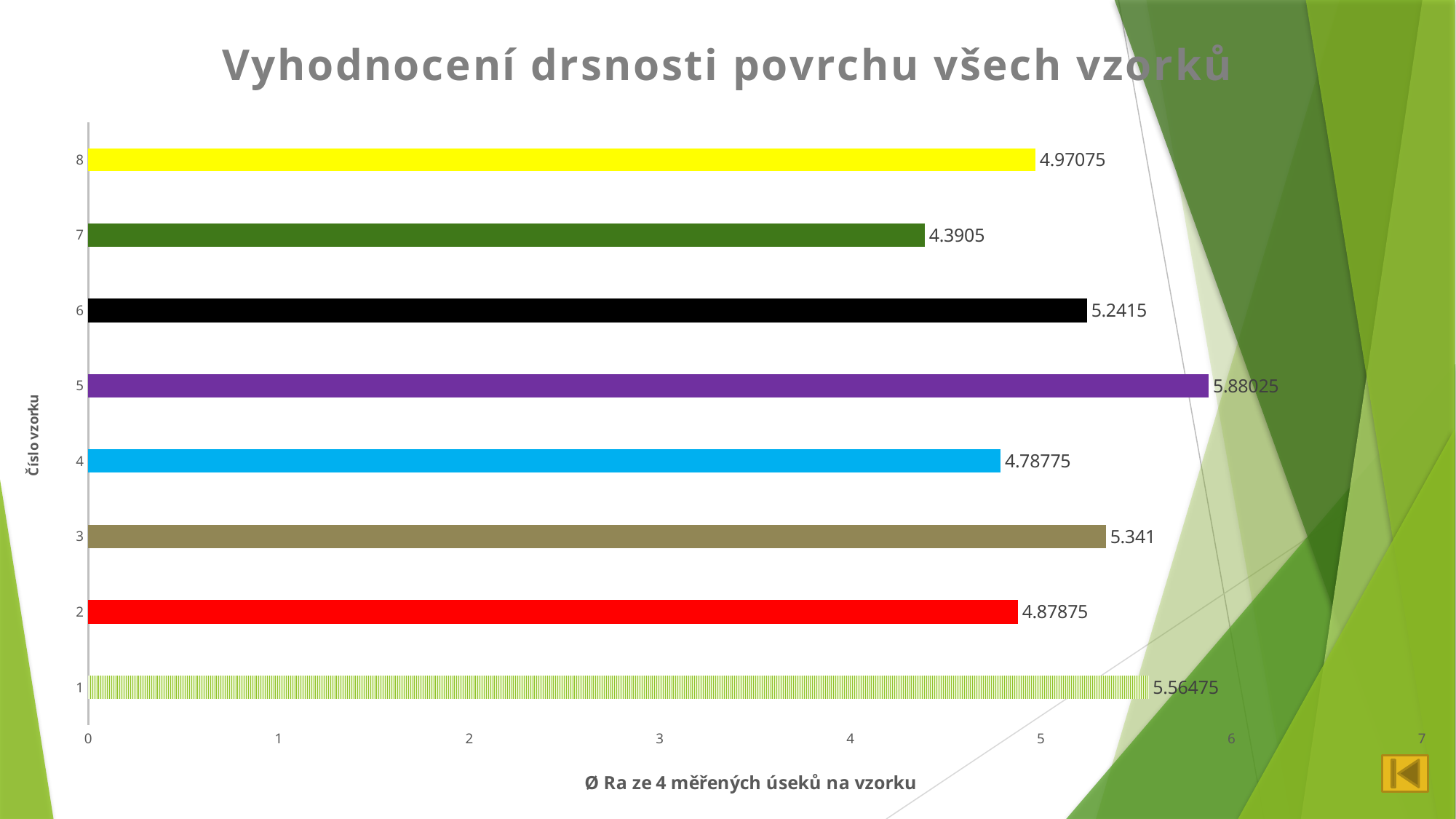
Which sample number has the lowest value? 7 Which sample number has the highest value? 5 What kind of chart is shown on the slide? bar chart What is the difference between the values for sample 5 and sample 7? 1.48975 Which has a larger value, sample 2 or sample 4? sample 2 Which has a larger value, sample 3 or sample 6? sample 3 What is the difference between the values for sample 1 and sample 2? 0.686 How many samples are shown in the chart? 8 What is the value for sample 1? 5.56475 What is the value for sample 7? 4.3905 What is the value for sample 5? 5.88025 What is the title of the horizontal axis? Ø Ra ze 4 měřených úseků na vzorku